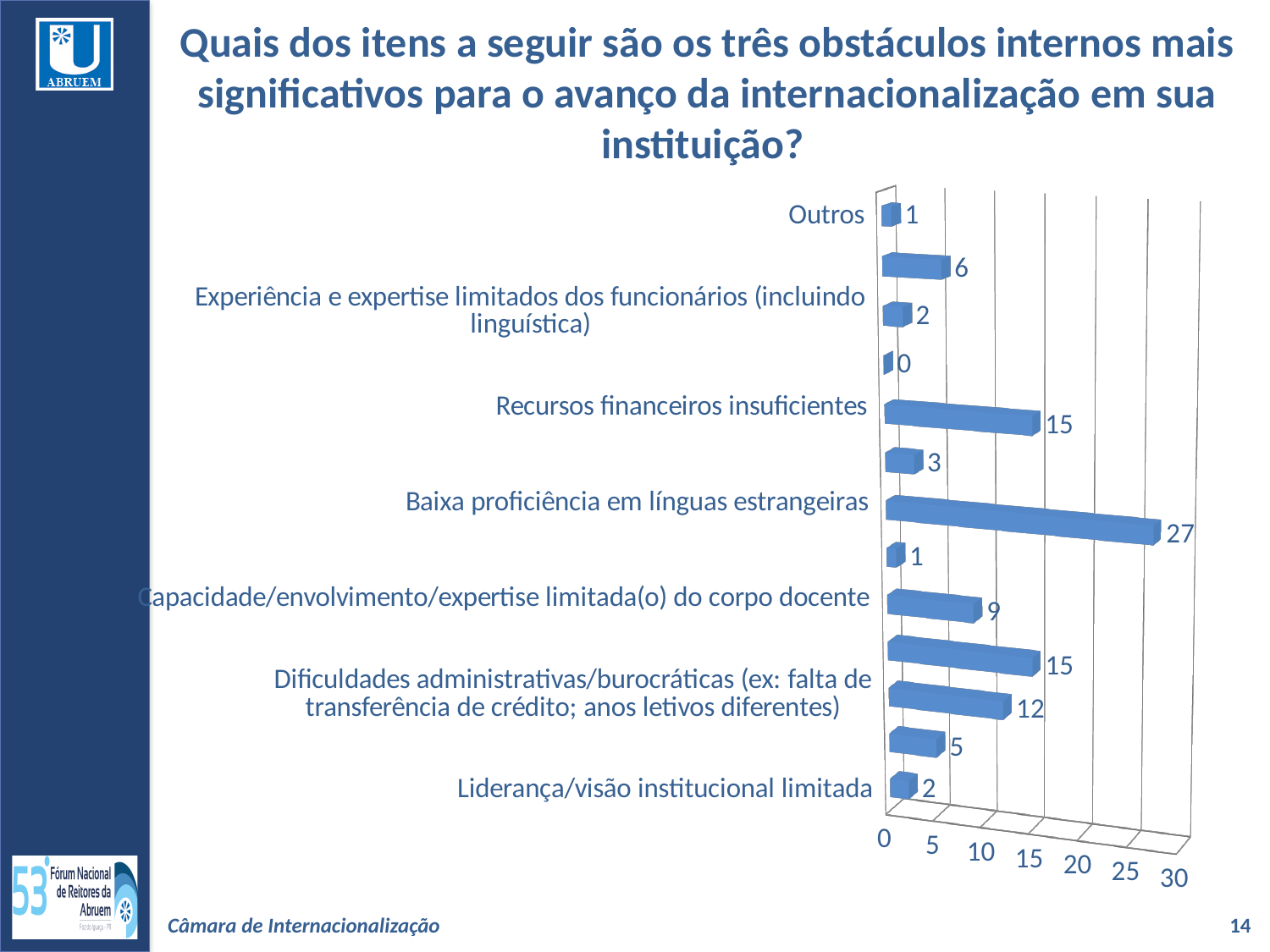
What is the value for "Recursos financeiros insuficientes"? 15 How many bars are plotted in the chart? 13 Which category has the highest value? Baixa proficiência em línguas estrangeiras Which is larger: the value for "Dificuldades administrativas/burocráticas" or the value for "Capacidade/envolvimento/expertise limitada(o) do corpo docente"? Dificuldades administrativas/burocráticas What is the difference between the values for "Baixa proficiência em línguas estrangeiras" and "Recursos financeiros insuficientes"? 12 What is the value for "Dificuldades administrativas/burocráticas (ex: falta de transferência de crédito; anos letivos diferentes)"? 12 What is the value for "Liderança/visão institucional limitada"? 2 What is the value for "Baixa proficiência em línguas estrangeiras"? 27 What is the value for "Capacidade/envolvimento/expertise limitada(o) do corpo docente"? 9 What is the value for "Outros"? 1 What is the highest value shown on the horizontal axis? 30 What type of chart is shown on the slide? bar chart